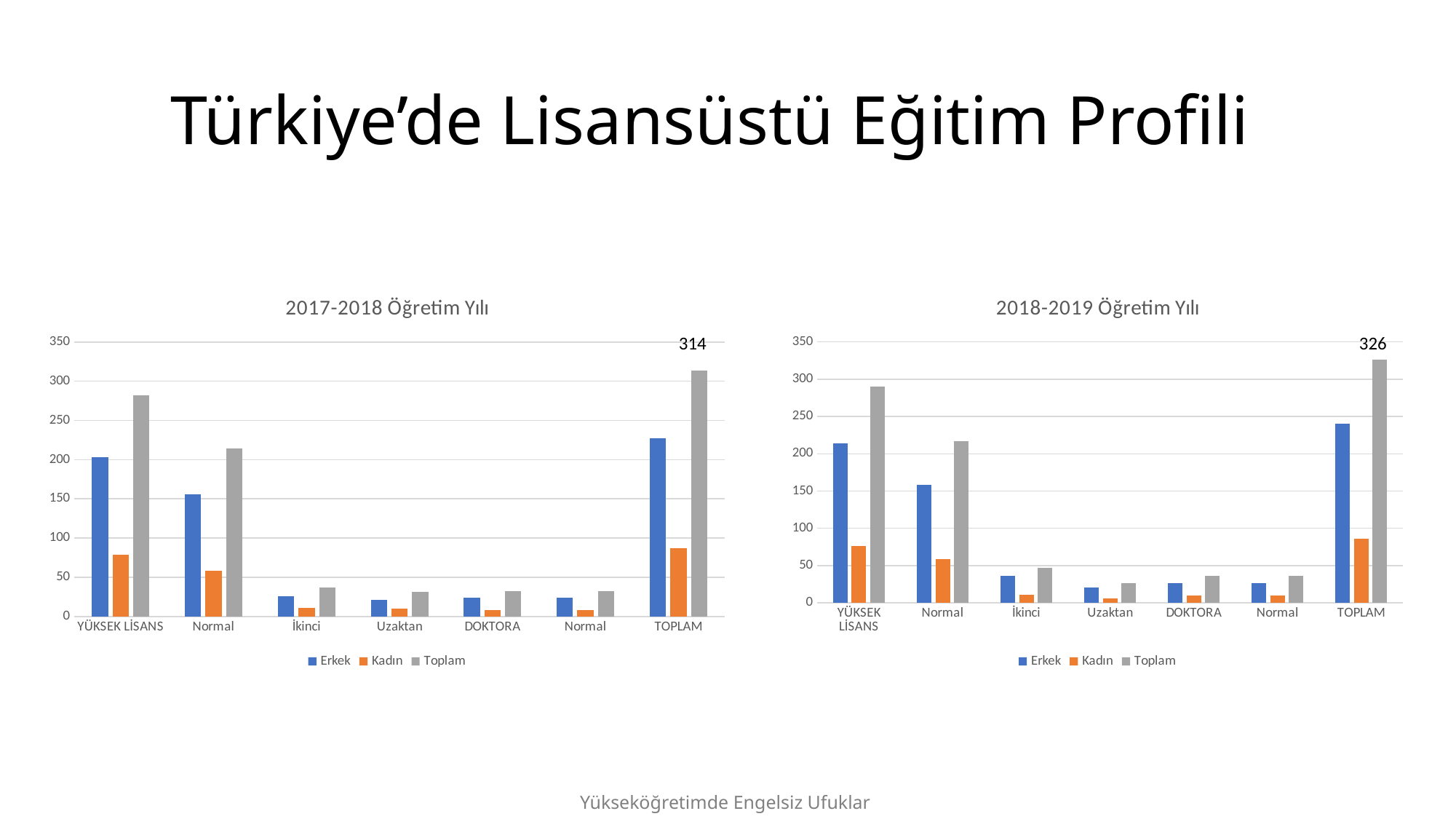
In the 2017-2018 Öğretim Yılı chart, which is larger, the Erkek value for YÜKSEK LİSANS or the Erkek value for Normal (next to it)? YÜKSEK LİSANS How many categories are shown on the x axis of the 2017-2018 Öğretim Yılı chart? 7 In the 2018-2019 Öğretim Yılı chart, is the Toplam value for YÜKSEK LİSANS greater or less than 250? greater In the 2017-2018 Öğretim Yılı chart, what is the Toplam value for TOPLAM? 314 Which chart shows the larger Toplam value for TOPLAM, 2017-2018 Öğretim Yılı or 2018-2019 Öğretim Yılı? 2018-2019 Öğretim Yılı In the 2017-2018 Öğretim Yılı chart, is the Erkek value for YÜKSEK LİSANS greater or less than 150? greater What are the legend entries in the 2018-2019 Öğretim Yılı chart? Erkek, Kadın, Toplam How many series does the legend of the 2018-2019 Öğretim Yılı chart list? 3 In the 2018-2019 Öğretim Yılı chart, what is the Toplam value for TOPLAM? 326 What kind of chart is the 2017-2018 Öğretim Yılı chart? Bar chart In the 2017-2018 Öğretim Yılı chart, which category has the highest Toplam value? TOPLAM What is the difference between the TOPLAM Toplam value in the 2018-2019 Öğretim Yılı chart and the one in the 2017-2018 Öğretim Yılı chart? 12